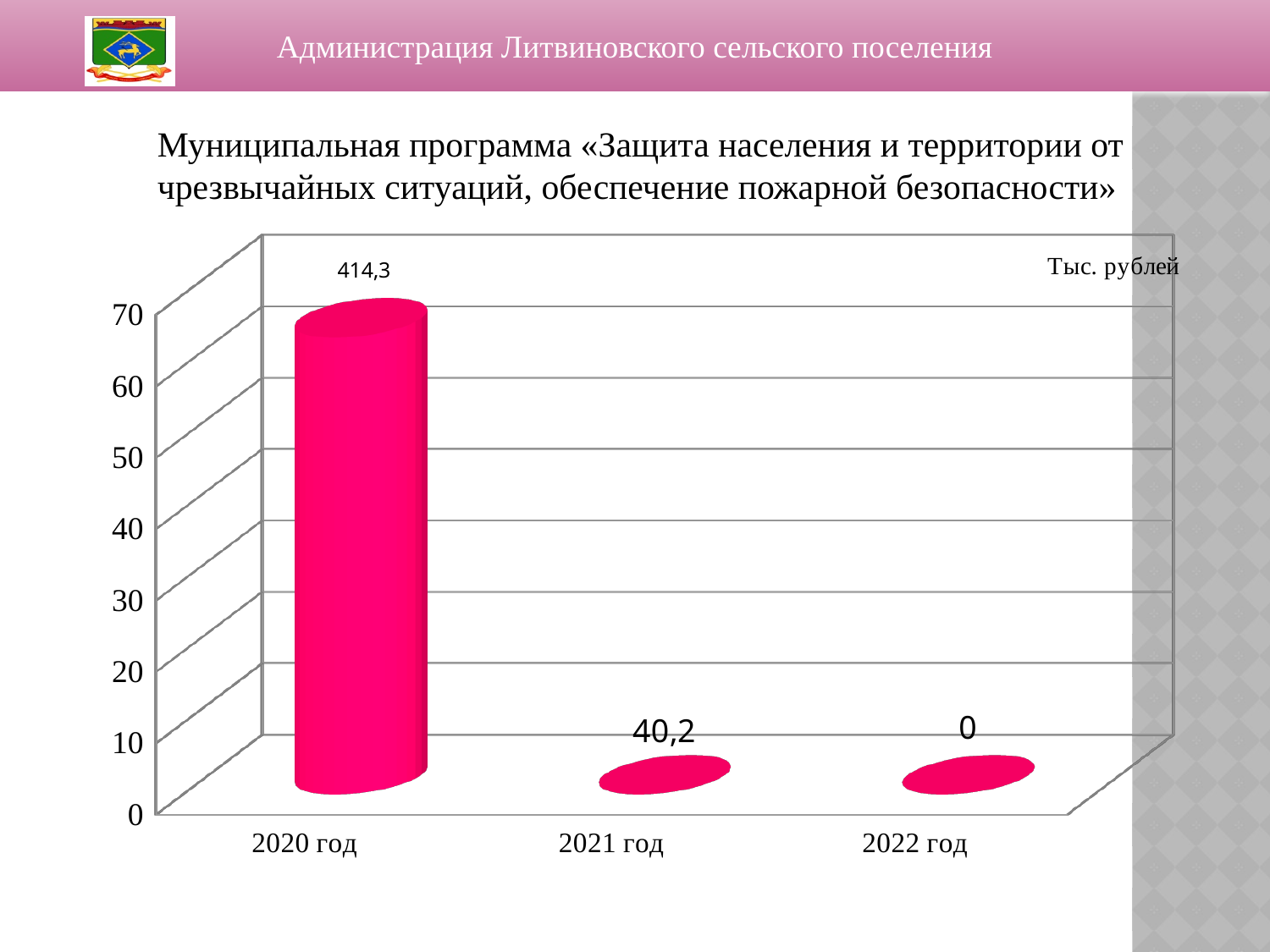
What is the value for 2020 год? 414,3 Which year has the highest value? 2020 год Do the values rise or fall from 2020 год to 2022 год? fall What is the value for 2021 год? 40,2 How many years are shown on the x axis? 3 What colour are the bars in the chart? pink Which year has the lowest value? 2022 год What kind of chart is shown on the slide? bar chart What unit is indicated in the top right corner of the chart? Тыс. рублей What is the value for 2022 год? 0 What is the difference between the values for 2020 год and 2021 год? 374,1 Which is larger, the value for 2021 год or the value for 2022 год? 2021 год